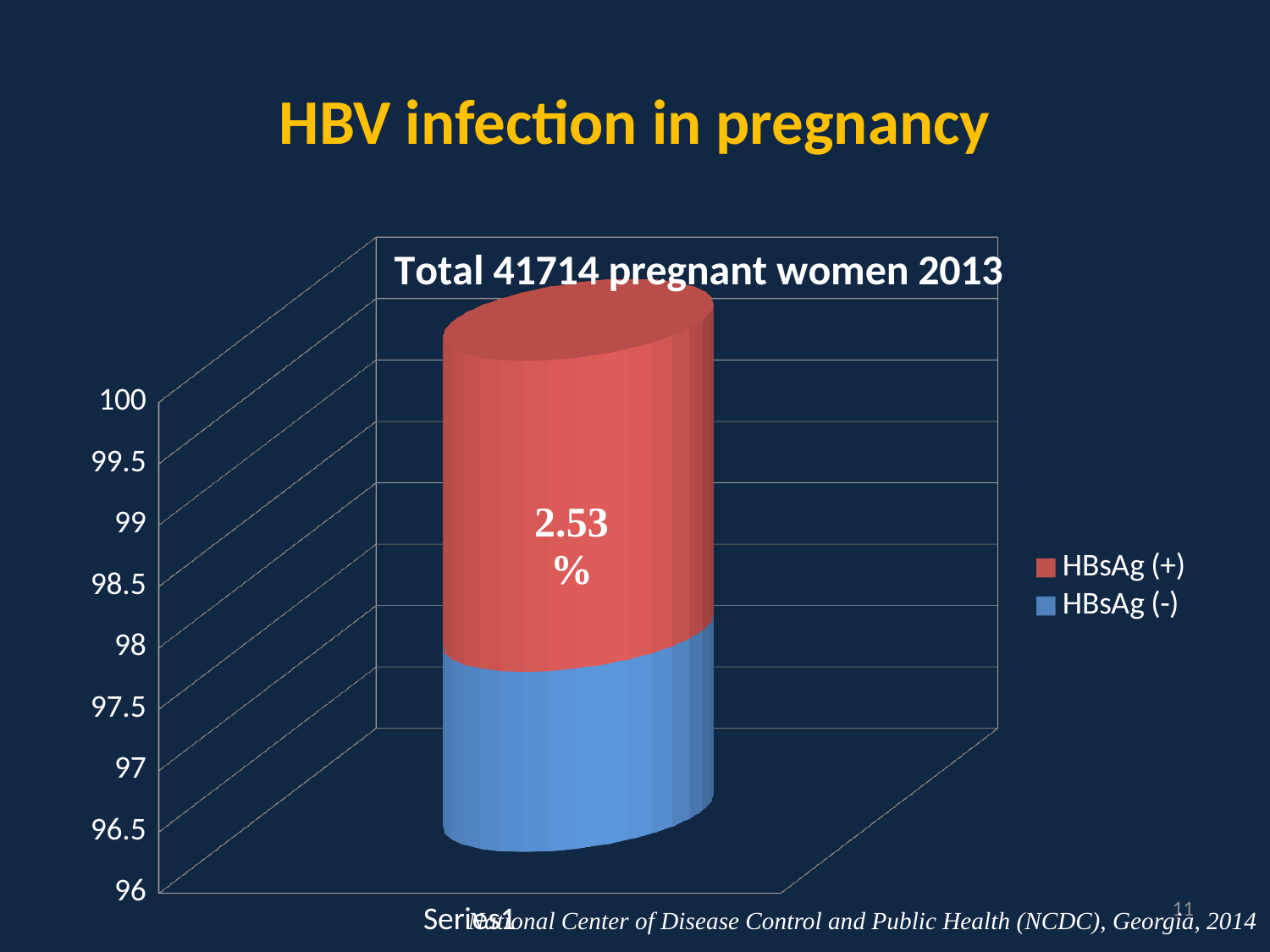
How many series does the legend list? 2 How many categories are plotted on the horizontal axis? 1 What kind of chart is shown on the slide? bar chart What value is labelled on the HBsAg (+) segment of the bar? 2.53% What is the title of the chart? Total 41714 pregnant women 2013 Which colour represents HBsAg (-) in the legend? blue